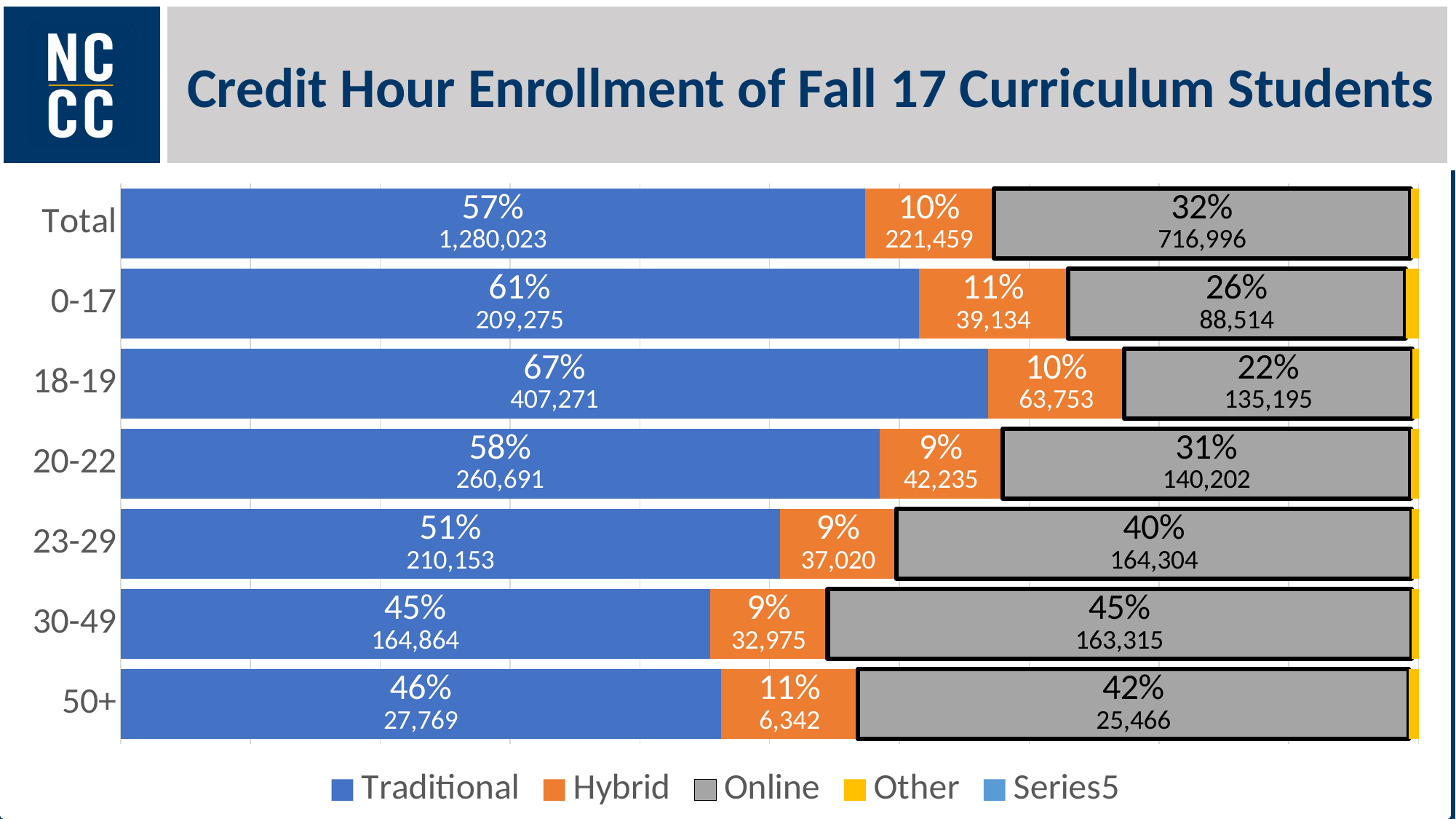
What percentage of credit hours for the 30-49 age group is Online? 45% Which age group has the lowest Online percentage? 18-19 Which age group has the highest Traditional percentage? 18-19 How many rows (categories) are shown on the chart, including Total? 7 What is the title of the slide? Credit Hour Enrollment of Fall 17 Curriculum Students What is the difference between Traditional and Hybrid credit hours for the 50+ age group? 21,427 How many credit hours of Traditional enrollment are shown for the 18-19 age group? 407,271 How many series does the legend list? 5 What kind of chart is shown on the slide? Stacked bar chart Which age group has the lowest Traditional percentage? 30-49 Which has more Online credit hours, the 20-22 group or the 18-19 group? 20-22 How many Hybrid credit hours are shown for the Total row? 221,459